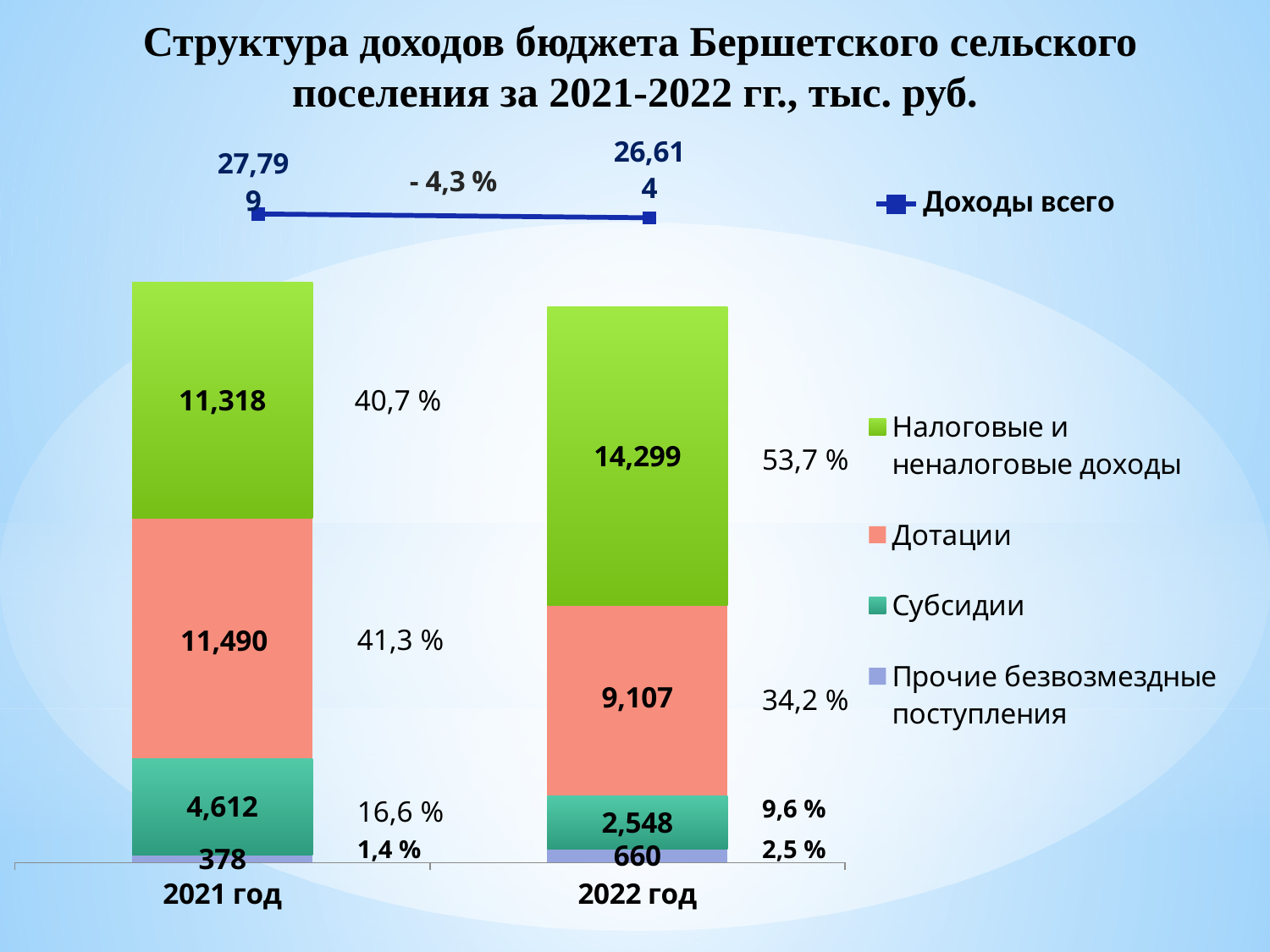
Which income category has the largest value in 2022 год? Налоговые и неналоговые доходы What kind of chart is shown on the slide? Stacked bar chart What is the total of the stacked bar for 2022 год? 26,614 Which income category has the smallest value in 2021 год? Прочие безвозмездные поступления How many years (categories) are shown on the x axis? 2 Which is larger in 2021 год: Дотации or Налоговые и неналоговые доходы? Дотации What share of total income do Налоговые и неналоговые доходы make up in 2022 год? 53,7 % What is the difference between Дотации in 2021 год and Дотации in 2022 год? 2,383 What is the value for Субсидии in 2022 год? 2,548 What is the value for Налоговые и неналоговые доходы in 2022 год? 14,299 What is the value for Дотации in 2021 год? 11,490 What is the value for Прочие безвозмездные поступления in 2021 год? 378